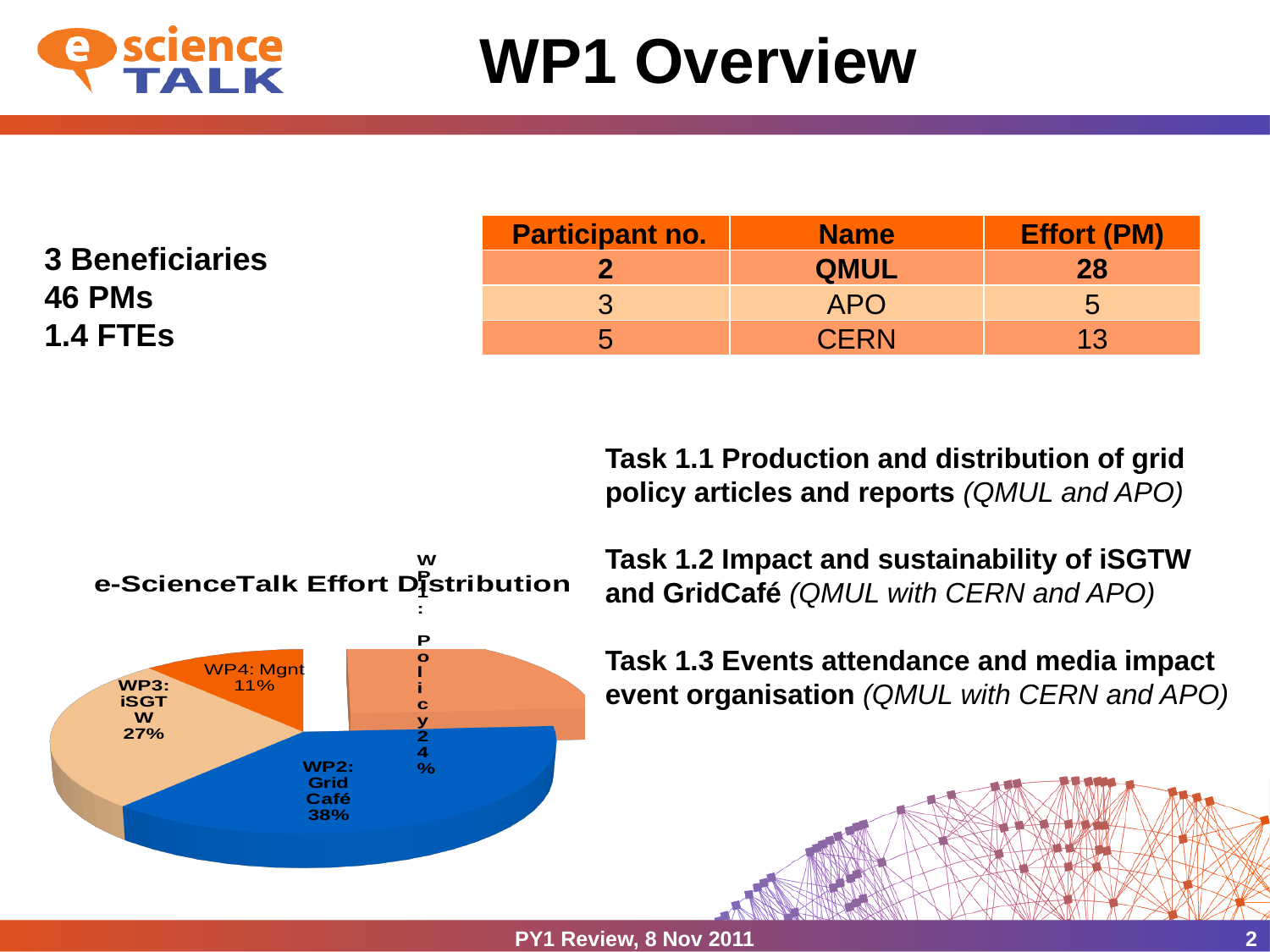
What share of the pie does WP2: Grid Café have? 38% Which slice of the pie chart is the largest? WP2: Grid Café What share of the pie does WP3: iSGTW have? 27% How many slices does the pie chart have? 4 Which slice of the pie chart is the smallest? WP4: Mgnt What is the difference in percentage points between the WP3: iSGTW slice and the WP4: Mgnt slice? 16 What share of the pie does WP1: Policy have? 24% What is the difference in percentage points between the WP2: Grid Café slice and the WP3: iSGTW slice? 11 What is the title of the chart on the slide? e-ScienceTalk Effort Distribution Which slice is larger, WP3: iSGTW or WP1: Policy? WP3: iSGTW What type of chart is shown on the slide? pie chart